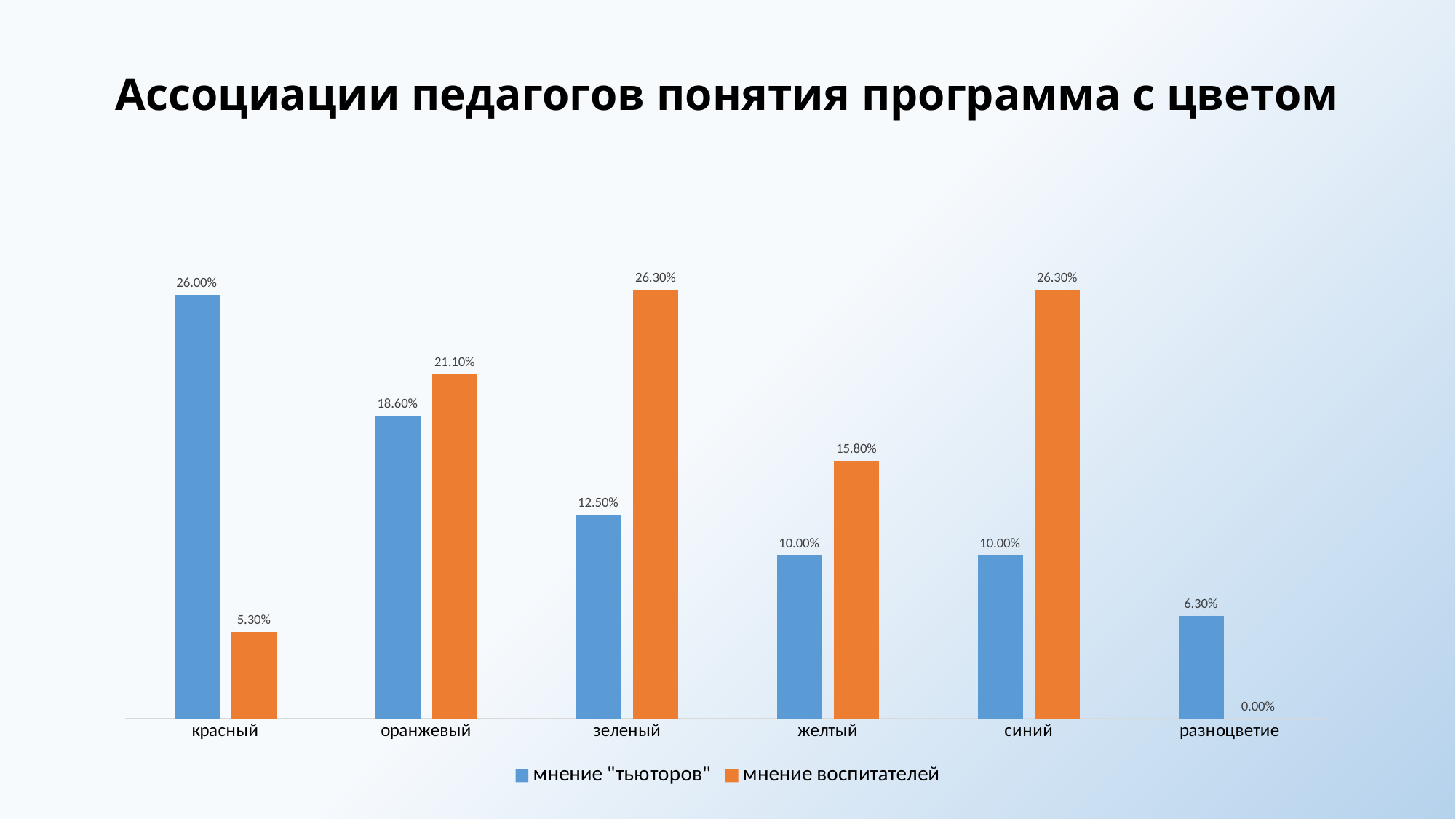
Which category has the highest value for мнение "тьюторов"? красный How many series does the legend list? 2 In the желтый category, which series has the larger value: мнение "тьюторов" or мнение воспитателей? мнение воспитателей What is the value for мнение воспитателей in the зеленый category? 26.30% What kind of chart is shown on the slide? bar chart What is the title of the chart? Ассоциации педагогов понятия программа с цветом What is the value for мнение "тьюторов" in the оранжевый category? 18.60% What is the value for мнение воспитателей in the разноцветие category? 0.00% What is the value for мнение "тьюторов" in the красный category? 26.00% Which category has the lowest value for мнение воспитателей? разноцветие What is the difference between мнение "тьюторов" and мнение воспитателей in the красный category? 20.70% How many categories are shown on the x axis? 6